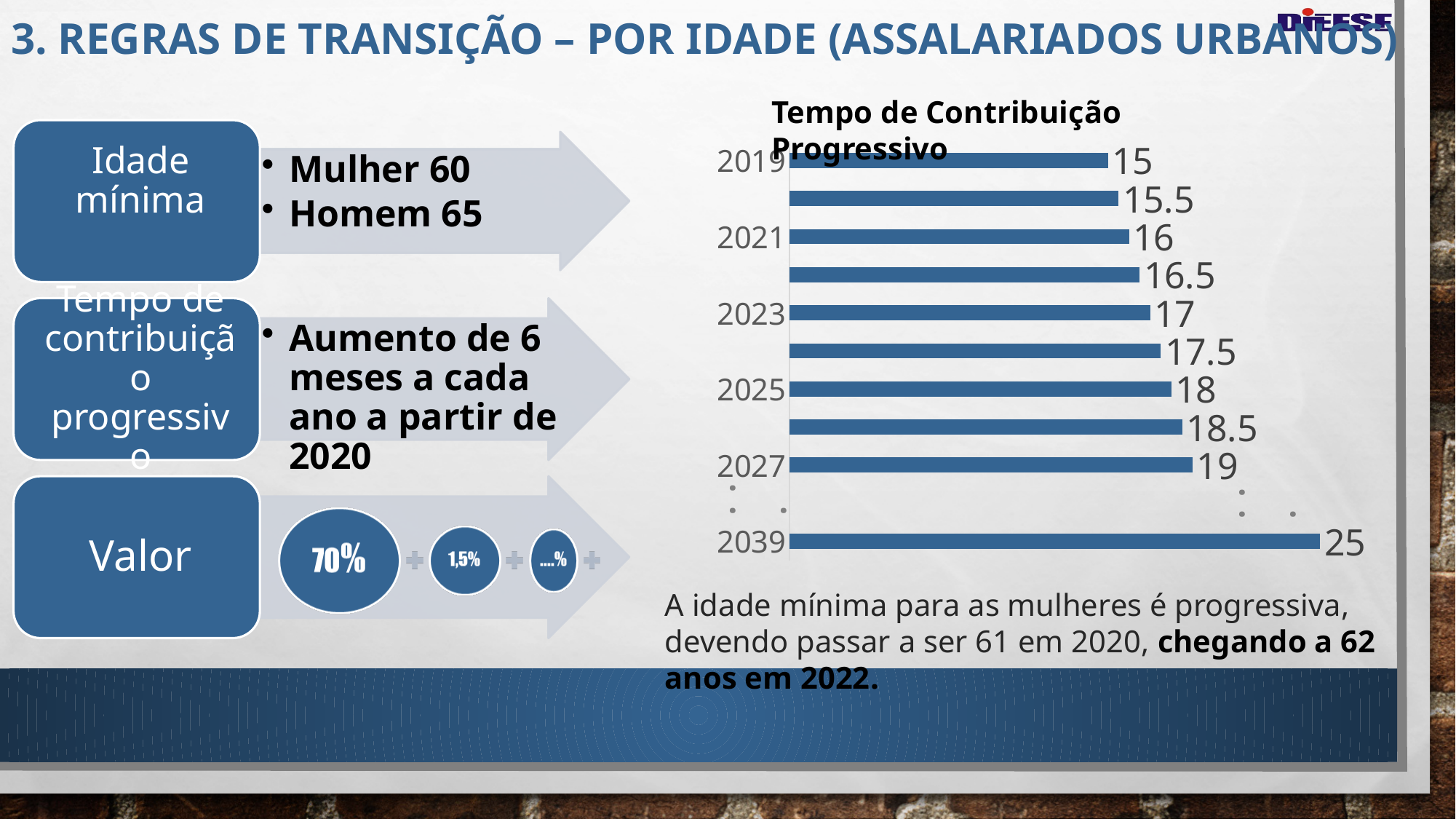
What is the value for 2021 in the chart? 16 What type of chart is shown on the slide? bar chart What is the value for 2019 in the chart? 15 Which year has the highest value in the chart? 2039 What is the value for 2025 in the chart? 18 What is the value for 2027 in the chart? 19 Which year has the lowest value in the chart? 2019 What is the difference between the values for 2039 and 2019? 10 What is the value for 2023 in the chart? 17 What is the title of the chart? Tempo de Contribuição Progressivo Do the values in the chart rise or fall as the years go from 2019 to 2039? rise What is the value for 2039 in the chart? 25